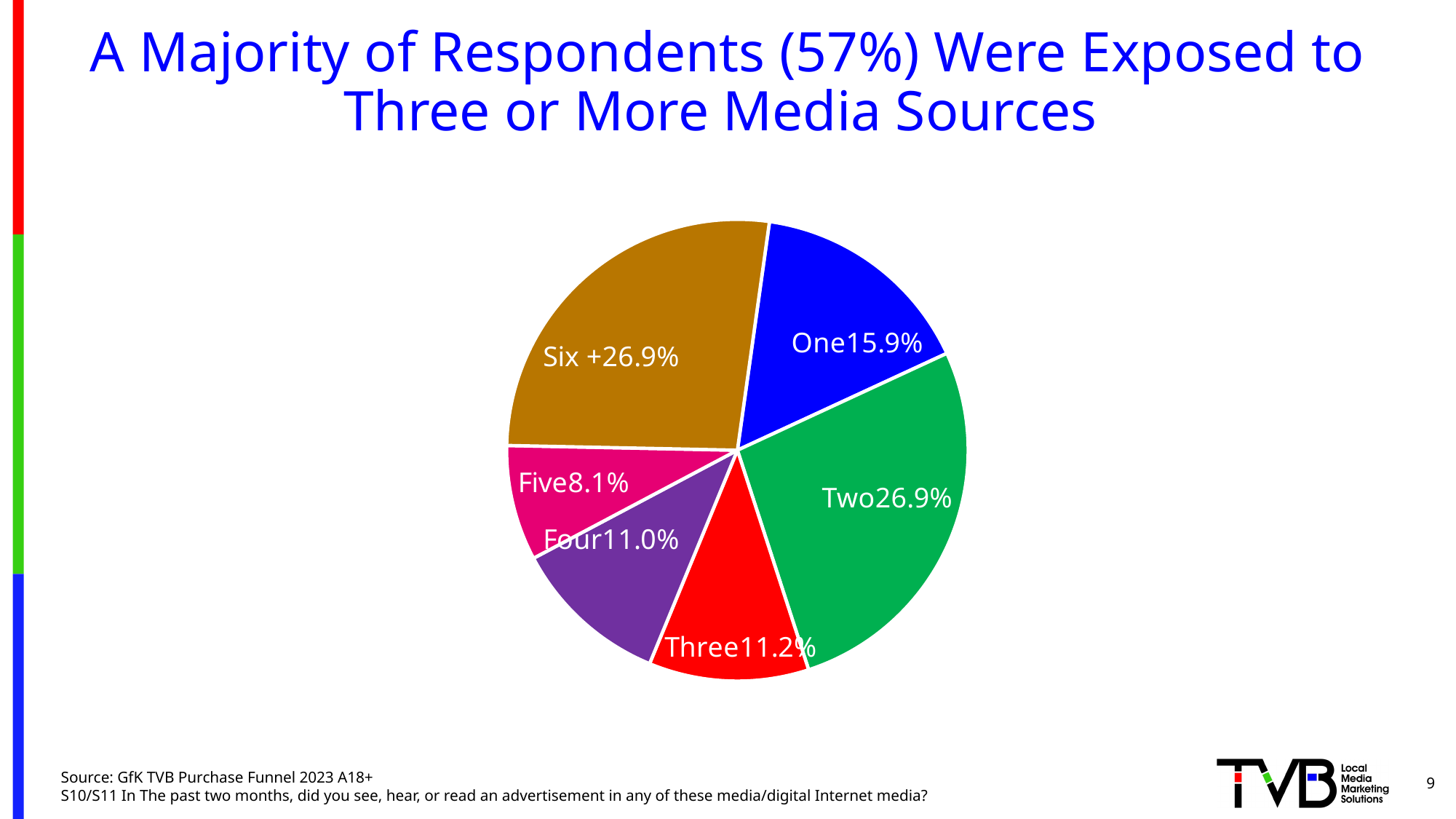
How many slices does the pie chart have? 6 What share of respondents were exposed to six or more media sources? 26.9% Which category has the smallest slice of the pie? Five What is the difference between the share for Two and the share for One? 11.0% What share of respondents were exposed to five media sources? 8.1% What share of respondents were exposed to three media sources? 11.2% Which is larger, the share for One or the share for Five? One What share of respondents were exposed to one media source? 15.9% What share of respondents were exposed to two media sources? 26.9% What colour is the slice for Three? red What share of respondents were exposed to four media sources? 11.0% What kind of chart is shown on the slide? pie chart